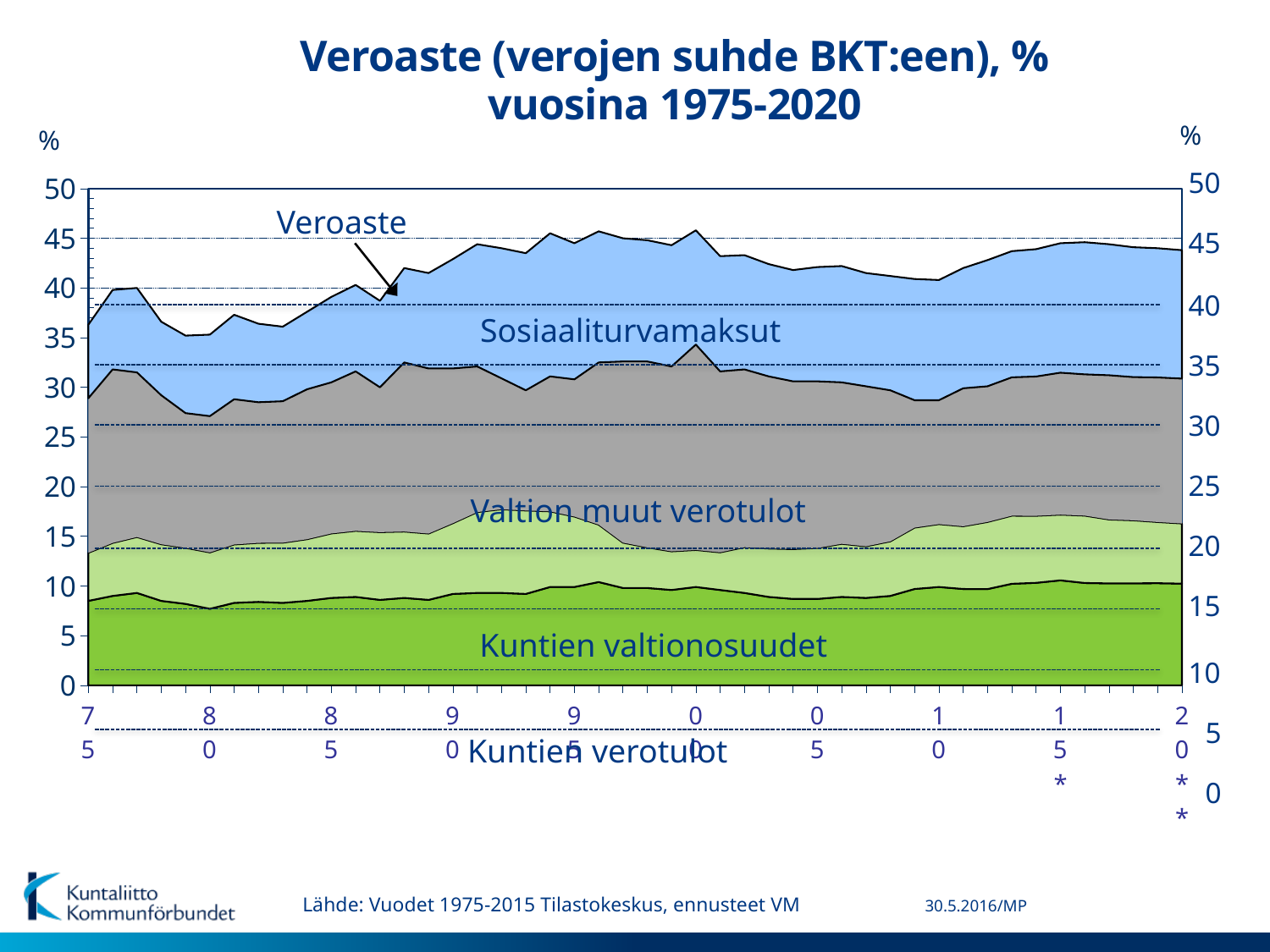
What is the highest value shown on the vertical axis? 50 Which series is plotted as the bottom (lowest) layer of the stacked area chart? Kuntien verotulot Is the Veroaste value at the end of the period (2020) greater or less than 40? greater Which of the stacked series occupies the thickest band in the chart? Valtion muut verotulot Does the Veroaste line rise or fall between 1975 and 1990? rise Is the Veroaste value around 1980 greater or less than 45? less Is the Kuntien verotulot value around 1980 greater or less than 10? less Which series is shown in blue at the top of the stack? Sosiaaliturvamaksut What is the title of the chart? Veroaste (verojen suhde BKT:een), % vuosina 1975-2020 What kind of chart is shown on the slide? Stacked area chart